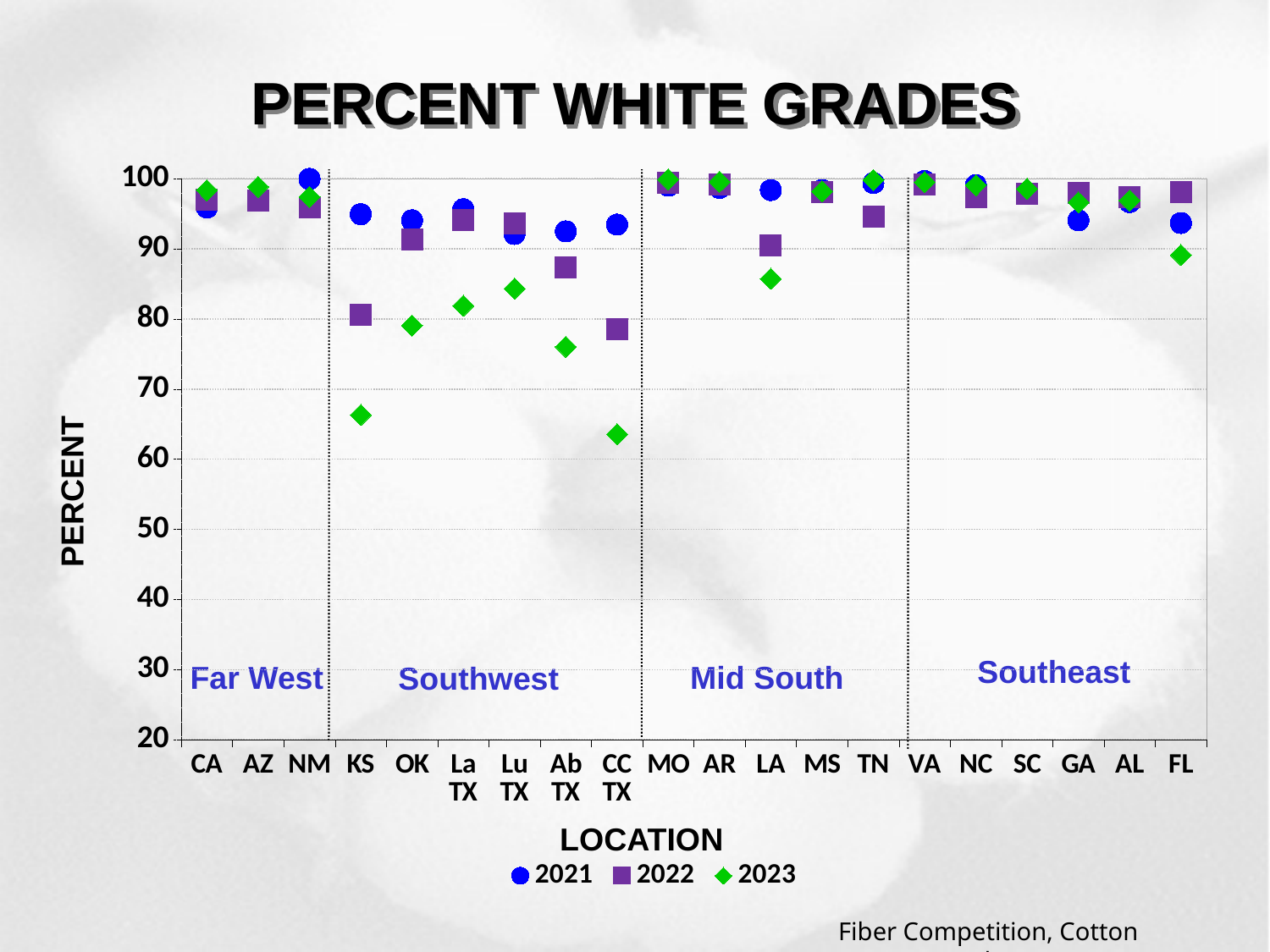
Is the 2023 value for LA greater or less than 80? greater What is the title of the chart? PERCENT WHITE GRADES How many series does the legend list? 3 Is the 2022 value for CC TX greater or less than 80? less Which marker shape and colour represents the 2023 series in the legend? green diamond Which location has the lowest 2023 value? CC TX How many locations are plotted along the x axis? 20 Is the 2023 value for KS greater or less than 70? less For KS, which series has the larger value, 2021 or 2023? 2021 What kind of chart is shown on the slide? scatter chart